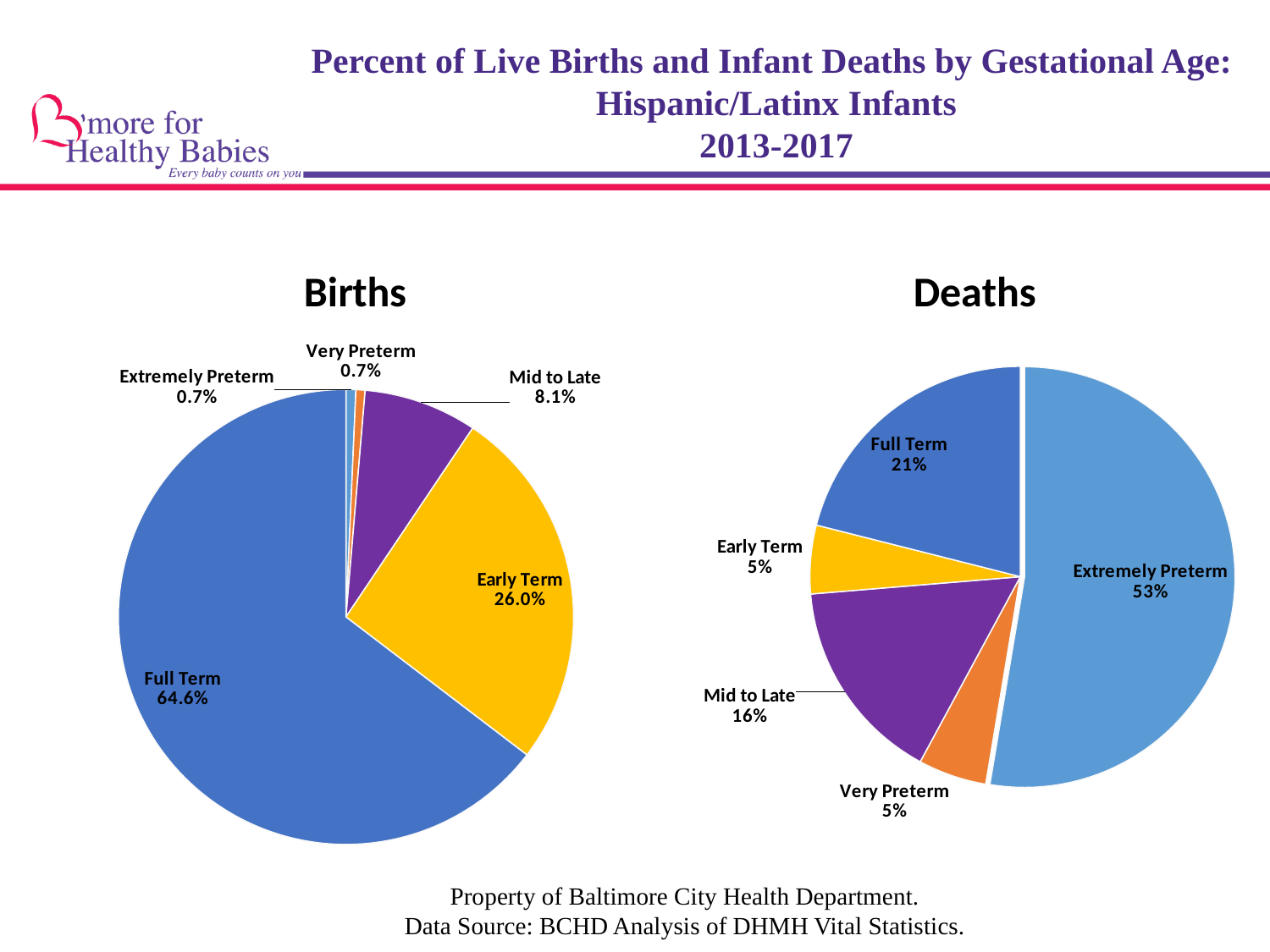
In the Births pie chart, what percentage of live births were Early Term? 26.0% In the Births pie chart, what percentage of live births were Mid to Late? 8.1% What type of chart is used for the Deaths data? Pie chart In the Deaths pie chart, what is the difference between the Extremely Preterm and Full Term shares? 32% In the Deaths pie chart, what percentage of infant deaths were Extremely Preterm? 53% In the Births pie chart, what percentage of live births were Full Term? 64.6% In the Deaths pie chart, which is larger, the Full Term share or the Mid to Late share? Full Term In the Births pie chart, what is the difference between the Full Term and Early Term shares? 38.6% In the Births pie chart, which gestational age category has the largest share? Full Term In the Deaths pie chart, which gestational age category has the largest share? Extremely Preterm In the Deaths pie chart, what percentage of infant deaths were Mid to Late? 16% How many gestational age categories are shown in the Births pie chart? 5